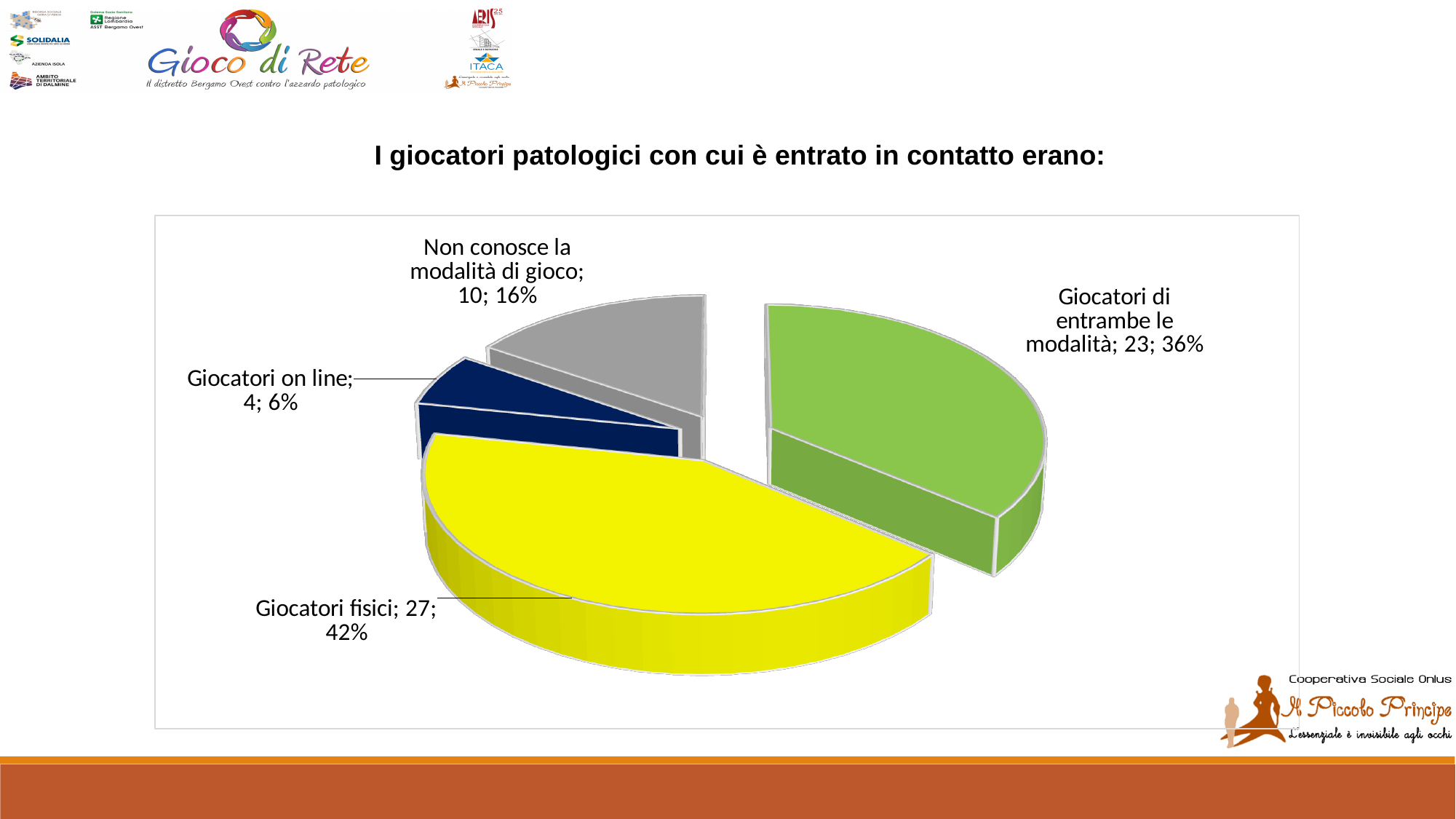
What is the value for Giocatori fisici? 27 What colour is the slice for Giocatori di entrambe le modalità? Green How many slices does the pie chart have? 4 What is the total of all the values in the pie chart? 64 Which is larger, the value for Non conosce la modalità di gioco or Giocatori on line? Non conosce la modalità di gioco What percentage share does Non conosce la modalità di gioco have? 16% What kind of chart is shown on the slide? Pie chart What percentage share does Giocatori di entrambe le modalità have? 36% What is the difference between the values for Giocatori fisici and Giocatori di entrambe le modalità? 4 Which category has the smallest slice? Giocatori on line What is the value for Giocatori on line? 4 Which category has the largest slice? Giocatori fisici